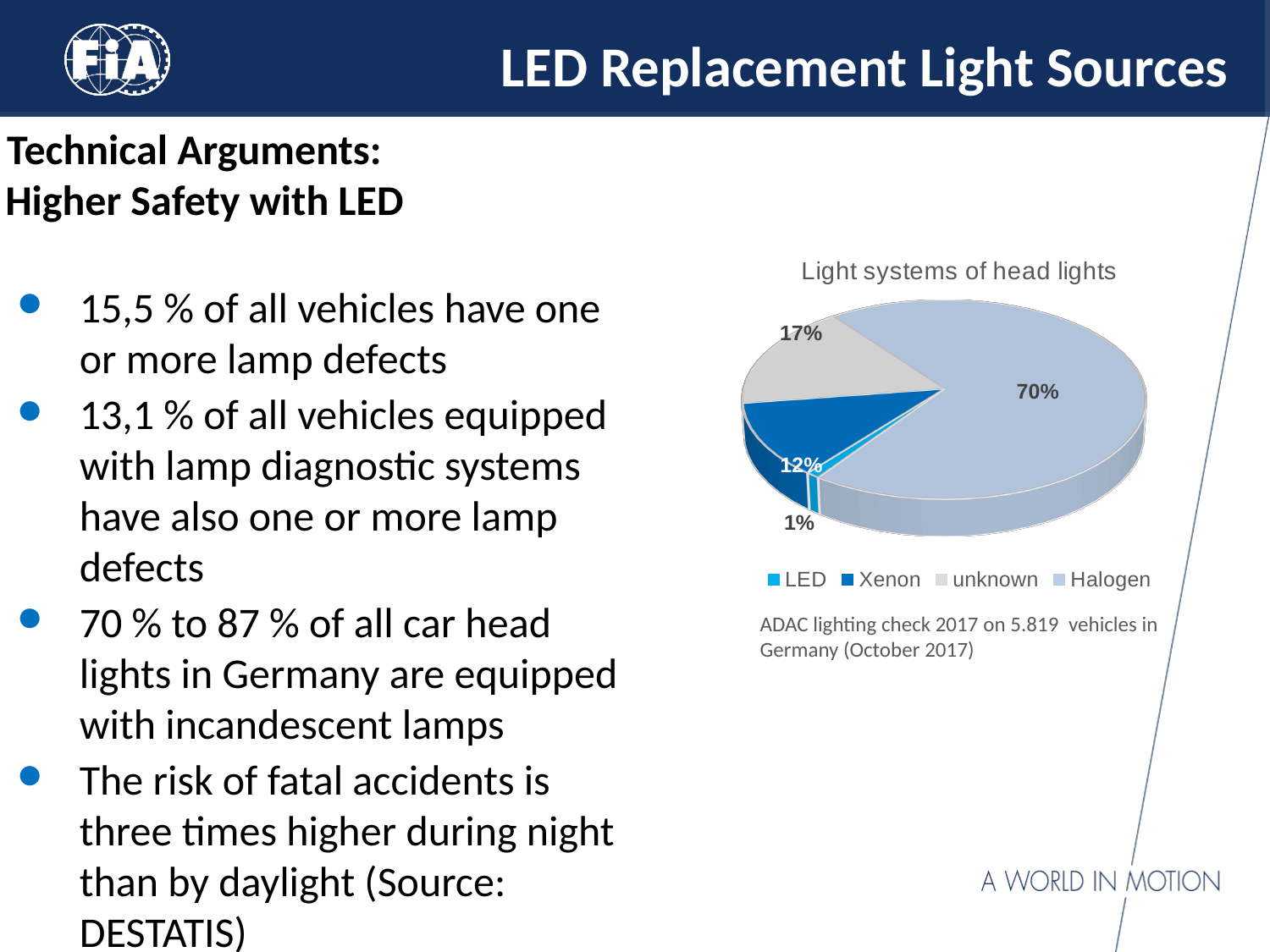
Which light system has the smallest slice of the pie? LED How many slices does the pie chart have? 4 What share of the pie does Halogen have? 70% What share of the pie is labelled unknown? 17% Which light system has the largest slice of the pie? Halogen How many entries does the legend list? 4 What is the title of the chart? Light systems of head lights What kind of chart is shown on the slide? pie chart What share of the pie does Xenon have? 12% Which slice is larger, unknown or Xenon? unknown What is the difference in percentage points between the Halogen and Xenon slices? 58 What share of the pie does LED have? 1%